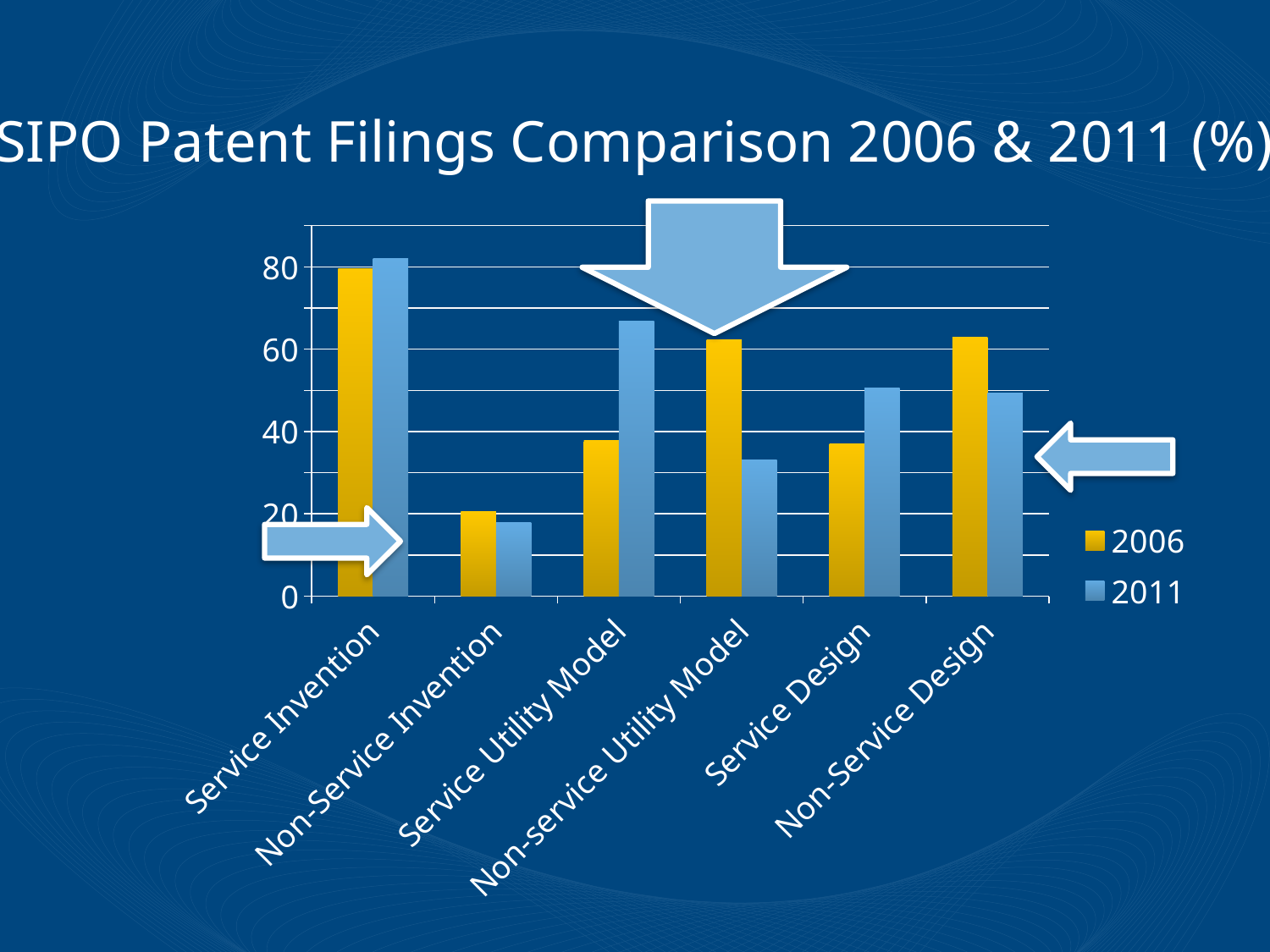
Is the value for Service Utility Model in 2011 greater or less than 60? greater For Service Utility Model, which year has the larger value, 2006 or 2011? 2011 Which category has the highest value for 2011? Service Invention Which category has the highest value for 2006? Service Invention What is the title of the chart? SIPO Patent Filings Comparison 2006 & 2011 (%) Is the value for Non-service Utility Model in 2011 greater or less than 40? less Which category has the lowest value for 2006? Non-Service Invention For Non-service Utility Model, which year has the larger value, 2006 or 2011? 2006 How many series does the legend list? 2 Which category has the lowest value for 2011? Non-Service Invention How many categories are shown on the x axis? 6 What kind of chart is shown on the slide? bar chart